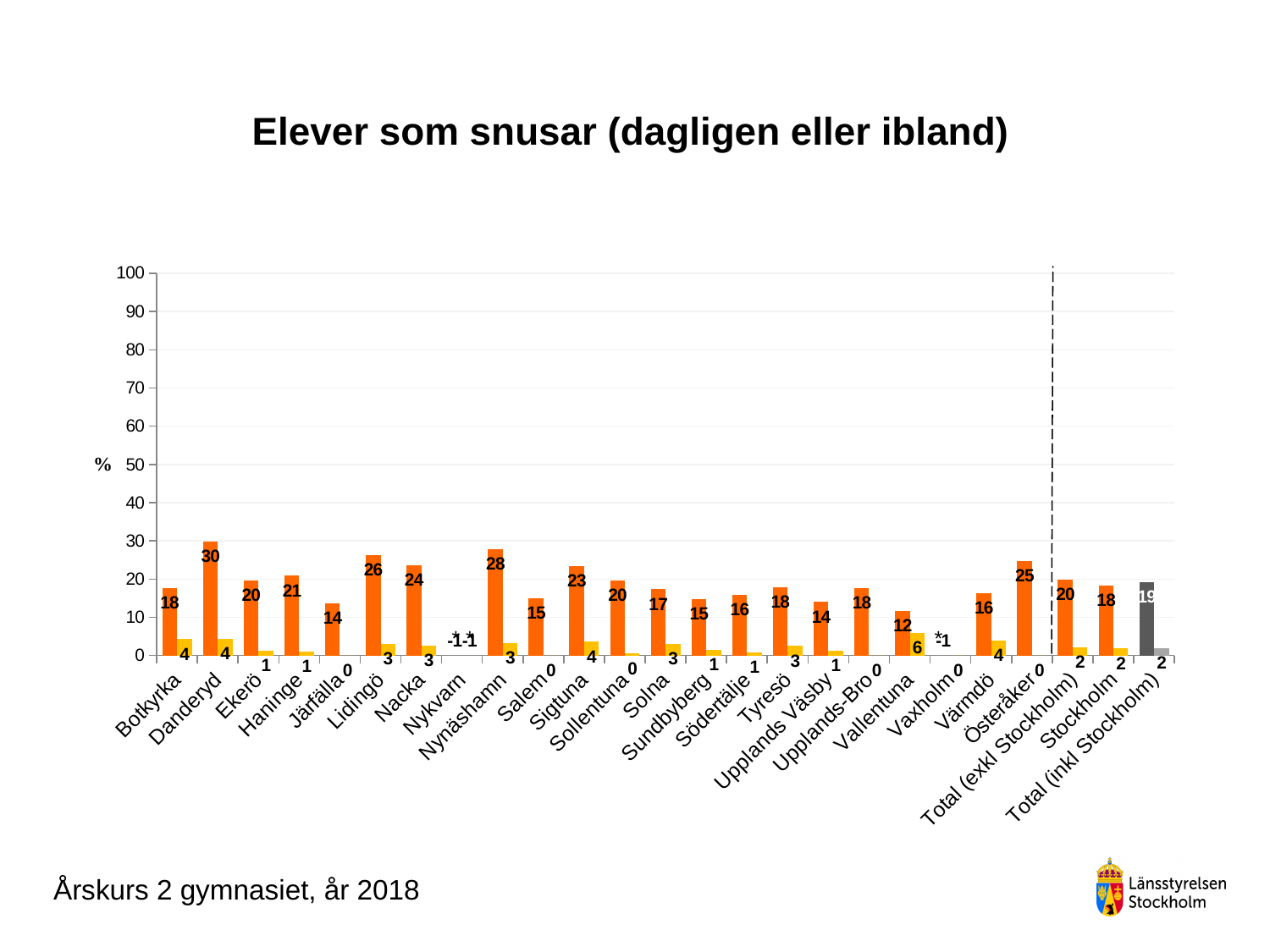
What is the title of the chart? Elever som snusar (dagligen eller ibland) How many categories are shown on the x axis? 25 What is the value of the yellow bar for Vallentuna? 6 Which has a larger orange bar value, Lidingö or Nacka? Lidingö What type of chart is shown on the slide? bar chart Which category has the highest orange bar? Danderyd Is the orange bar value for Österåker greater or less than 20? greater What is the value of the orange bar for Danderyd? 30 What is the value of the orange bar for Stockholm? 18 What is the difference between the orange bar values for Danderyd and Botkyrka? 12 What is the value of the orange bar for Nynäshamn? 28